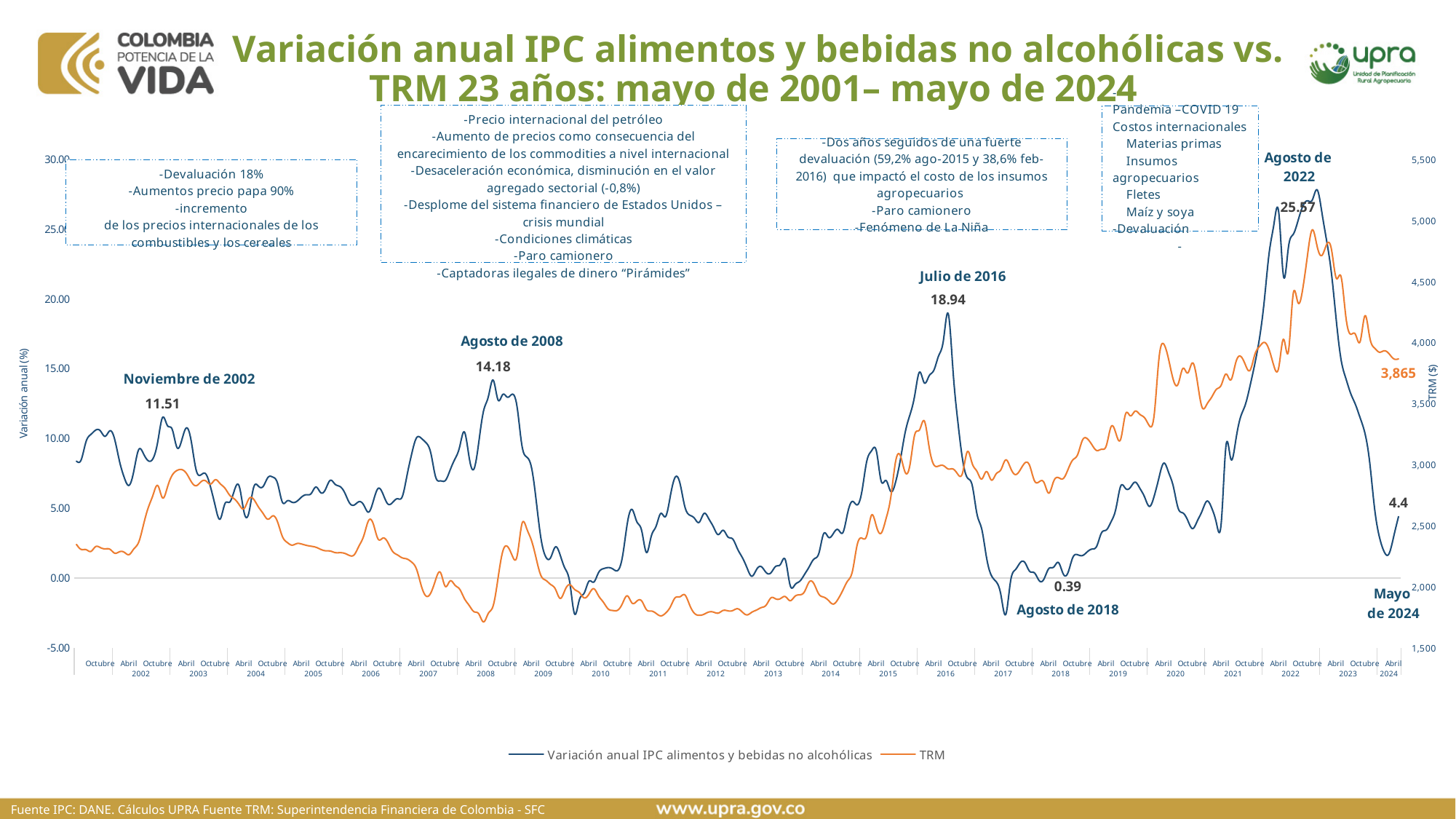
What kind of chart is shown on the slide? Line chart What value is labelled for Julio de 2016 on the IPC variation line? 18.94 What is the labelled IPC variation value for Mayo de 2024? 4.4 What is the labelled TRM value at the end of the series (2024)? 3,865 What is the labelled value of the annual IPC food and non-alcoholic beverages variation in Agosto de 2022? 25.57 What value is labelled for Agosto de 2018 on the IPC variation line? 0.39 How many series does the legend list? 2 What is the difference between the labelled IPC values for Agosto de 2022 and Julio de 2016? 6.63 Which labelled date has the highest IPC variation value on the chart? Agosto de 2022 Which labelled IPC value is larger: Agosto de 2008 or Noviembre de 2002? Agosto de 2008 What value is labelled for Noviembre de 2002 on the IPC variation line? 11.51 What value is labelled for Agosto de 2008 on the IPC variation line? 14.18